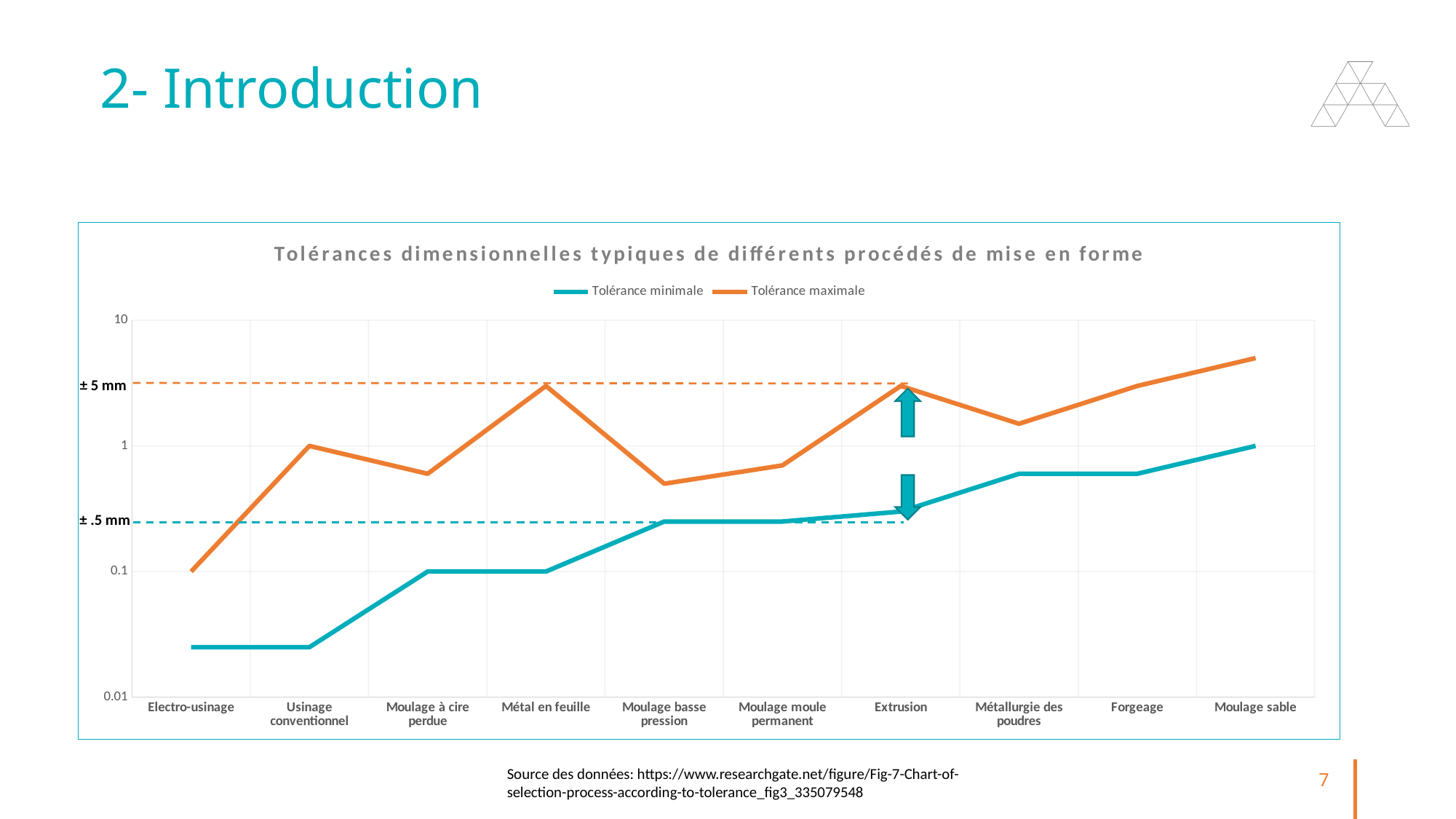
What is the Tolérance maximale value for Usinage conventionnel? 1 Which category has the lowest Tolérance maximale? Electro-usinage What is the title of the chart? Tolérances dimensionnelles typiques de différents procédés de mise en forme Which has the larger Tolérance maximale, Métal en feuille or Moulage basse pression? Métal en feuille What is the Tolérance minimale value for Métal en feuille? 0.1 How many series does the legend list? 2 How many process categories are shown on the x axis? 10 Is the Tolérance minimale value for Electro-usinage greater or less than 0.1? less What is the Tolérance maximale value for Electro-usinage? 0.1 What is the Tolérance minimale value for Moulage sable? 1 What kind of chart is shown on the slide? Line chart Which category has the highest Tolérance maximale? Moulage sable